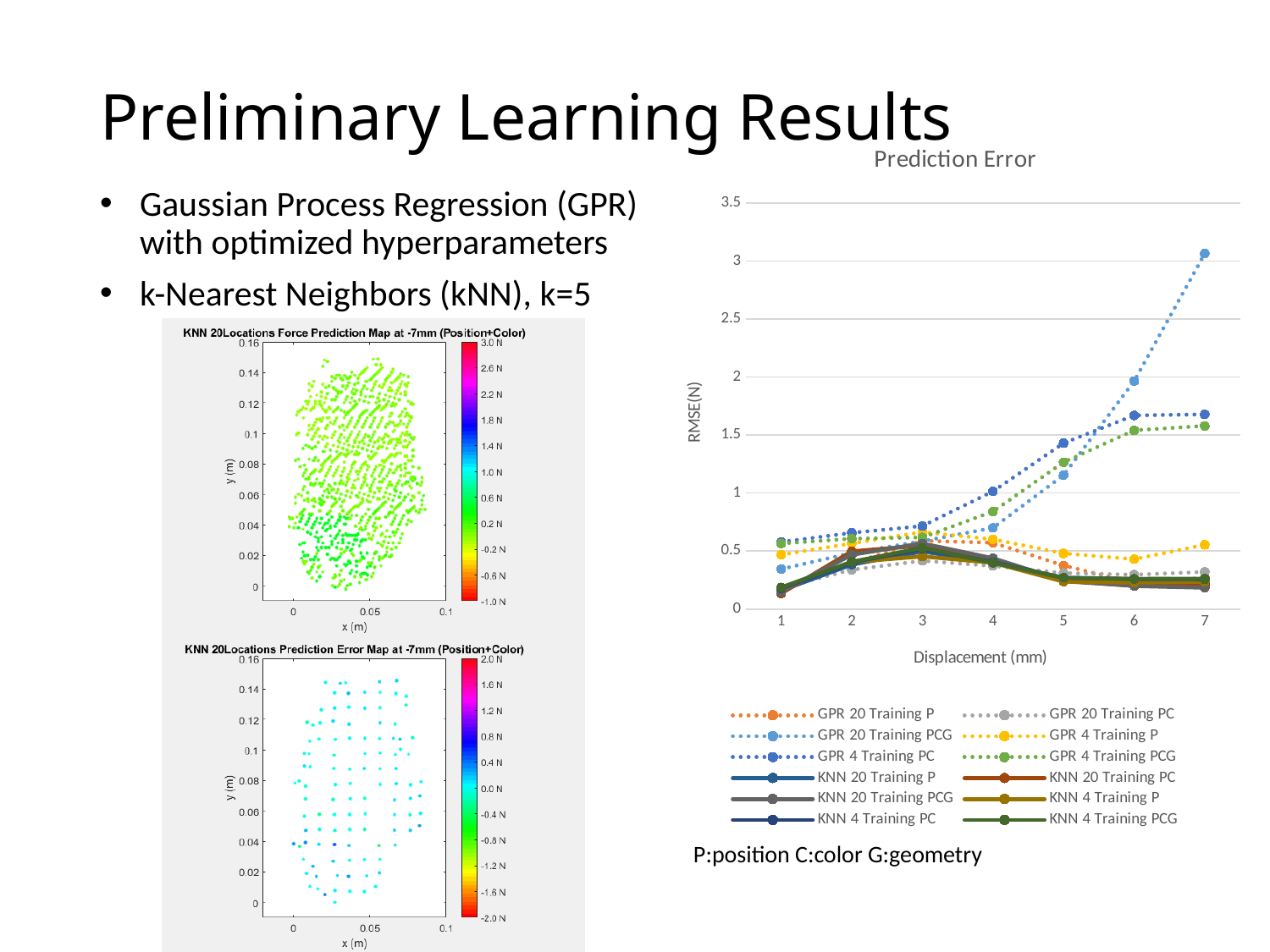
In the Prediction Error chart, is the RMSE of KNN 20 Training P at 7 mm displacement greater or less than 0.5? less What kind of chart is the Prediction Error chart? line chart According to the note under the Prediction Error chart legend, what does the letter G stand for? geometry What is the maximum value shown on the colour bar of the top-left KNN Force Prediction Map? 3.0 N In the Prediction Error chart, at 7 mm displacement, which has the larger RMSE: GPR 20 Training PCG or GPR 4 Training P? GPR 20 Training PCG How many series does the legend of the Prediction Error chart list? 12 In the Prediction Error chart, does the RMSE of GPR 20 Training PCG rise or fall as displacement increases from 1 mm to 7 mm? rise In the Prediction Error chart, is the RMSE of GPR 20 Training PCG at 7 mm displacement greater or less than 2.5? greater How many displacement values are plotted along the x axis of the Prediction Error chart? 7 What is the x-axis title of the Prediction Error chart? Displacement (mm) In the Prediction Error chart, is the RMSE of GPR 4 Training PCG at 6 mm displacement greater or less than 1? greater In the Prediction Error chart, which series has the highest RMSE at a displacement of 7 mm? GPR 20 Training PCG